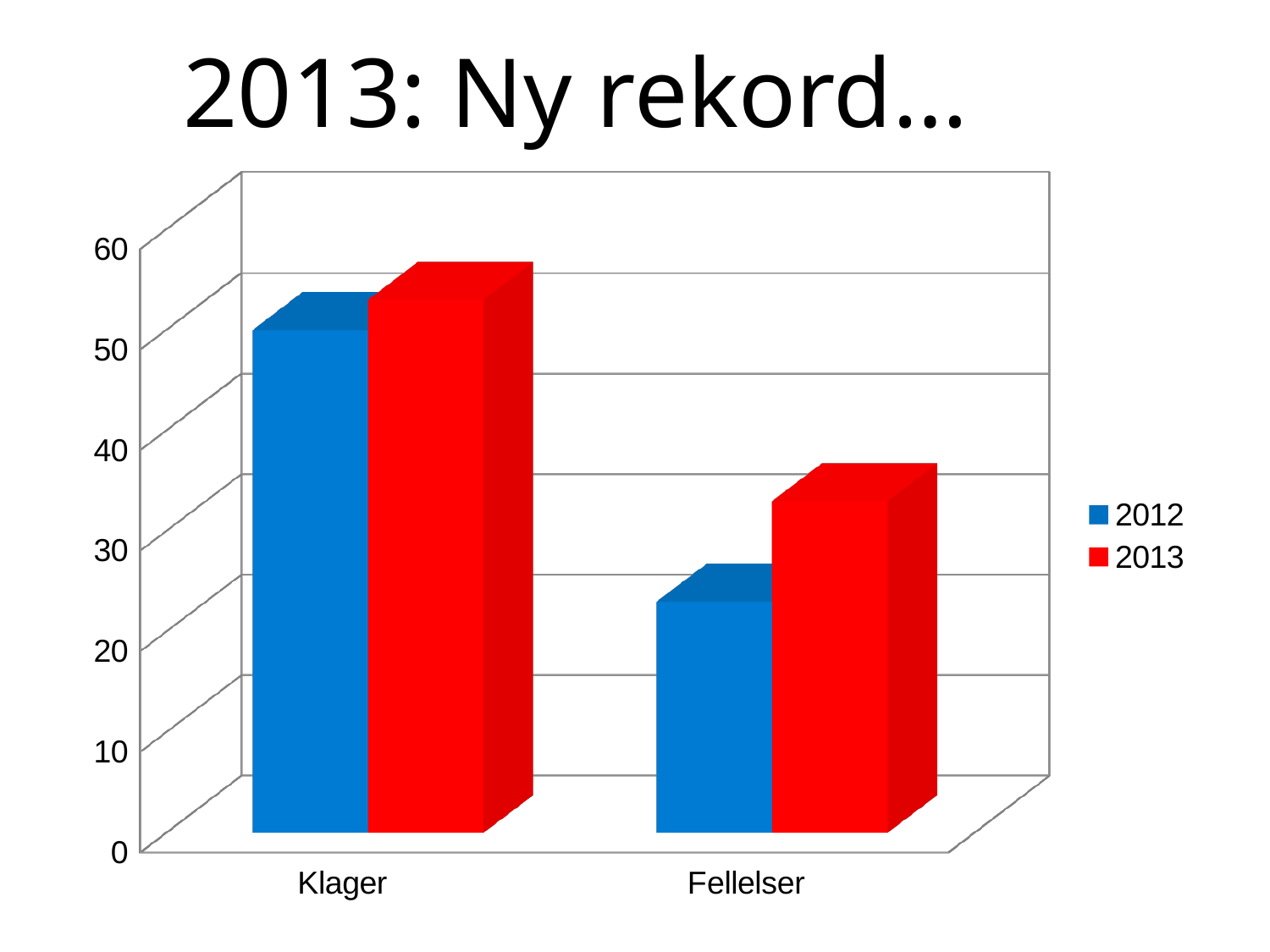
Is the value for Fellelser in 2013 greater or less than 20? greater For Fellelser, which series has the larger value, 2012 or 2013? 2013 How many series does the legend list? 2 Is the value for Klager in 2012 greater or less than 40? greater What is the title of the slide containing the chart? 2013: Ny rekord... Is the value for Fellelser in 2012 greater or less than 40? less Which category has the lowest bar in the chart? Fellelser What kind of chart is shown on the slide? bar chart For Klager, which series has the larger value, 2012 or 2013? 2013 Which category has the highest bar in the chart? Klager How many categories are shown on the x axis of the chart? 2 Which series are listed in the legend? 2012 and 2013